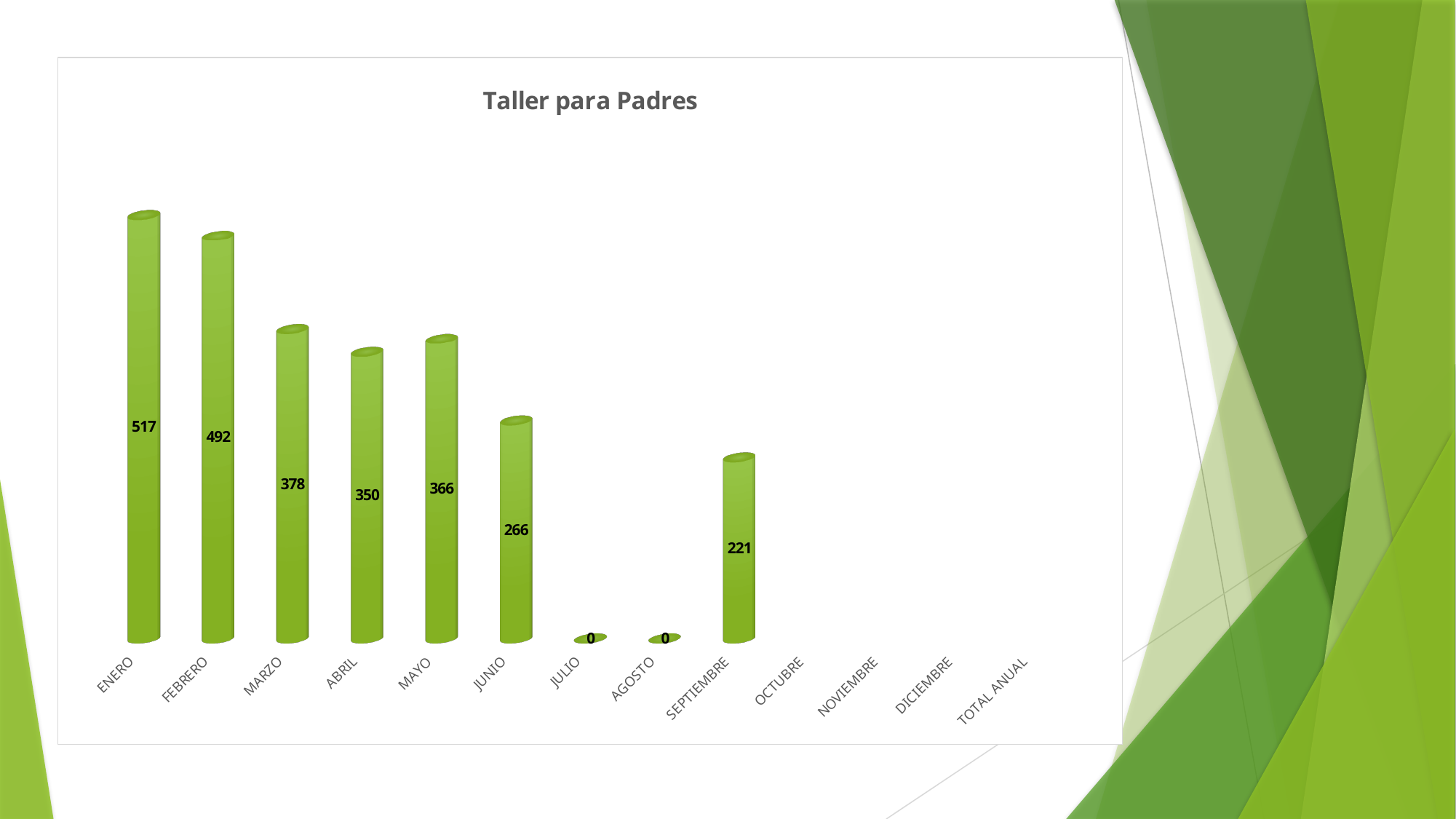
Which is larger, the value for ABRIL or the value for MAYO? MAYO What kind of chart is the Taller para Padres chart? Bar chart Do the values rise or fall from ENERO to JUNIO in the Taller para Padres chart? Fall Which month has the highest value in the Taller para Padres chart? ENERO What is the difference between the values for JUNIO and SEPTIEMBRE? 45 What is the value for ENERO in the Taller para Padres chart? 517 Which is larger, the value for MARZO or the value for JUNIO? MARZO What is the value for JULIO in the Taller para Padres chart? 0 What is the value for MAYO in the Taller para Padres chart? 366 How many category labels are shown on the x axis of the Taller para Padres chart? 13 What is the difference between the values for ENERO and FEBRERO? 25 What is the value for SEPTIEMBRE in the Taller para Padres chart? 221